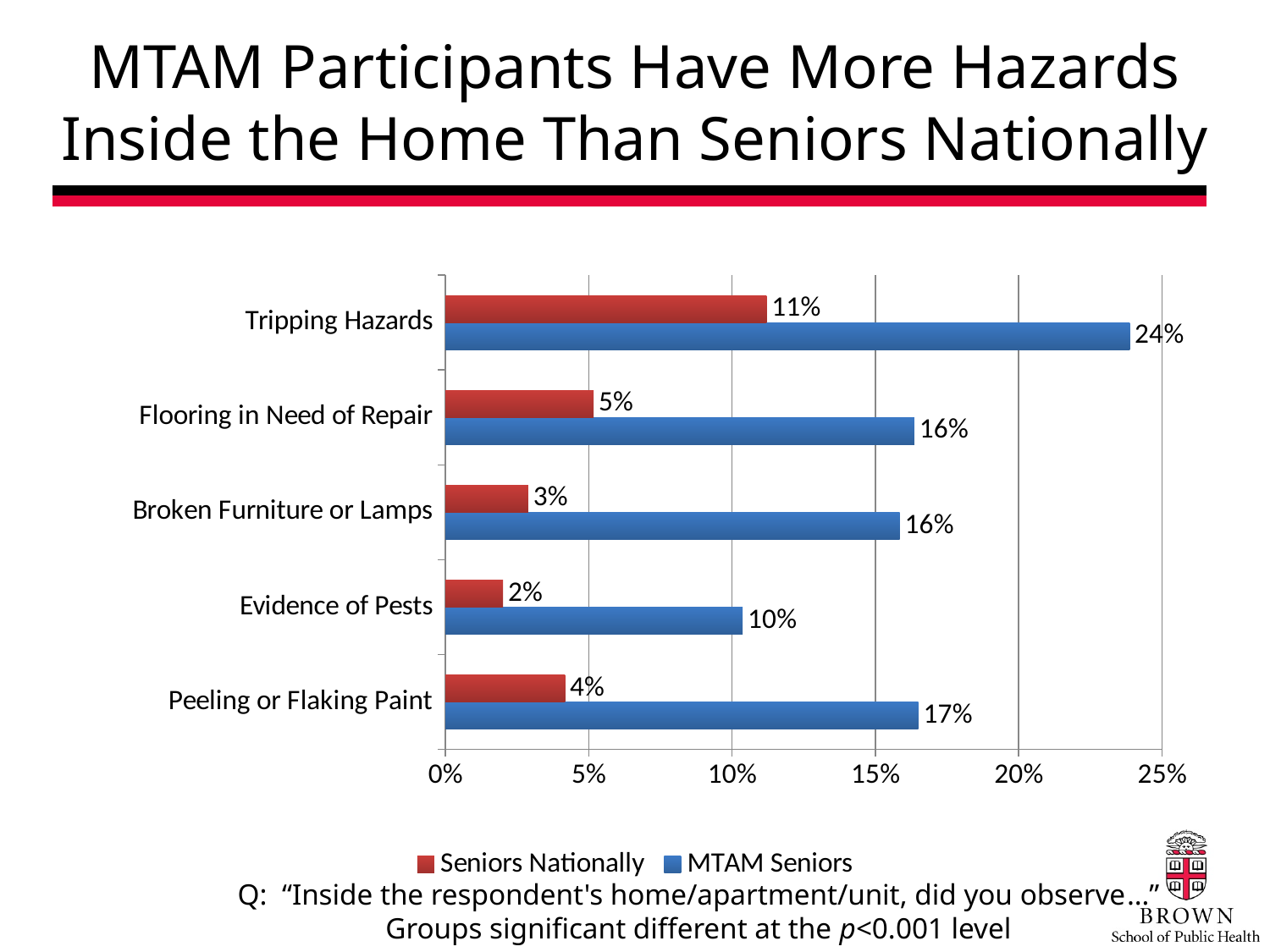
Which category has the highest value for MTAM Seniors? Tripping Hazards Which is larger for Broken Furniture or Lamps: Seniors Nationally or MTAM Seniors? MTAM Seniors How many categories are shown on the chart? 5 What is the value for MTAM Seniors for Evidence of Pests? 10% Which colour represents Seniors Nationally in the chart? Red Is the value for MTAM Seniors for Flooring in Need of Repair greater or less than 15%? greater Which category has the lowest value for Seniors Nationally? Evidence of Pests What kind of chart is shown on the slide? Bar chart What is the value for Seniors Nationally for Flooring in Need of Repair? 5% What is the value for MTAM Seniors for Tripping Hazards? 24% What is the difference between MTAM Seniors and Seniors Nationally for Peeling or Flaking Paint? 13% How many series does the legend list? 2